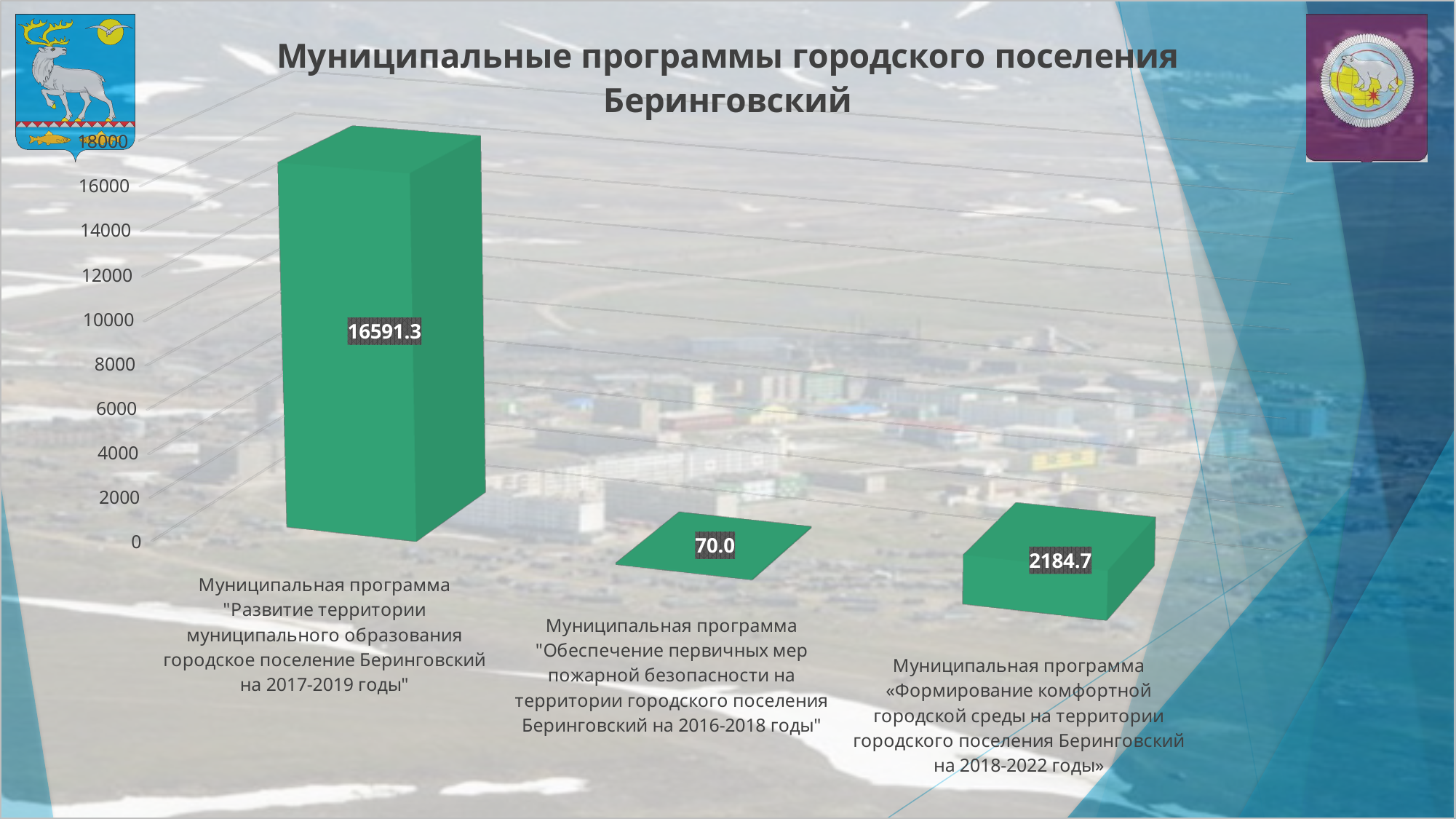
What is the title of the chart? Муниципальные программы городского поселения Беринговский What is the difference between the value for the "Развитие территории" program and the "Формирование комфортной городской среды" program? 14406.6 Which municipal program has the highest value on the chart? Муниципальная программа "Развитие территории муниципального образования городское поселение Беринговский на 2017-2019 годы" How many municipal programs are shown on the chart? 3 What is the value for the program «Формирование комфортной городской среды на территории городского поселения Беринговский на 2018-2022 годы»? 2184.7 Is the value for the "Развитие территории" program greater or less than 16000? greater What is the value for the program "Развитие территории муниципального образования городское поселение Беринговский на 2017-2019 годы"? 16591.3 Which is larger: the value for the "Формирование комфортной городской среды" program or the "Обеспечение первичных мер пожарной безопасности" program? Формирование комфортной городской среды What is the difference between the value for the "Формирование комфортной городской среды" program and the "Обеспечение первичных мер пожарной безопасности" program? 2114.7 Which municipal program has the lowest value on the chart? Муниципальная программа "Обеспечение первичных мер пожарной безопасности на территории городского поселения Беринговский на 2016-2018 годы" What is the value for the program "Обеспечение первичных мер пожарной безопасности на территории городского поселения Беринговский на 2016-2018 годы"? 70.0 What type of chart is shown on the slide? bar chart